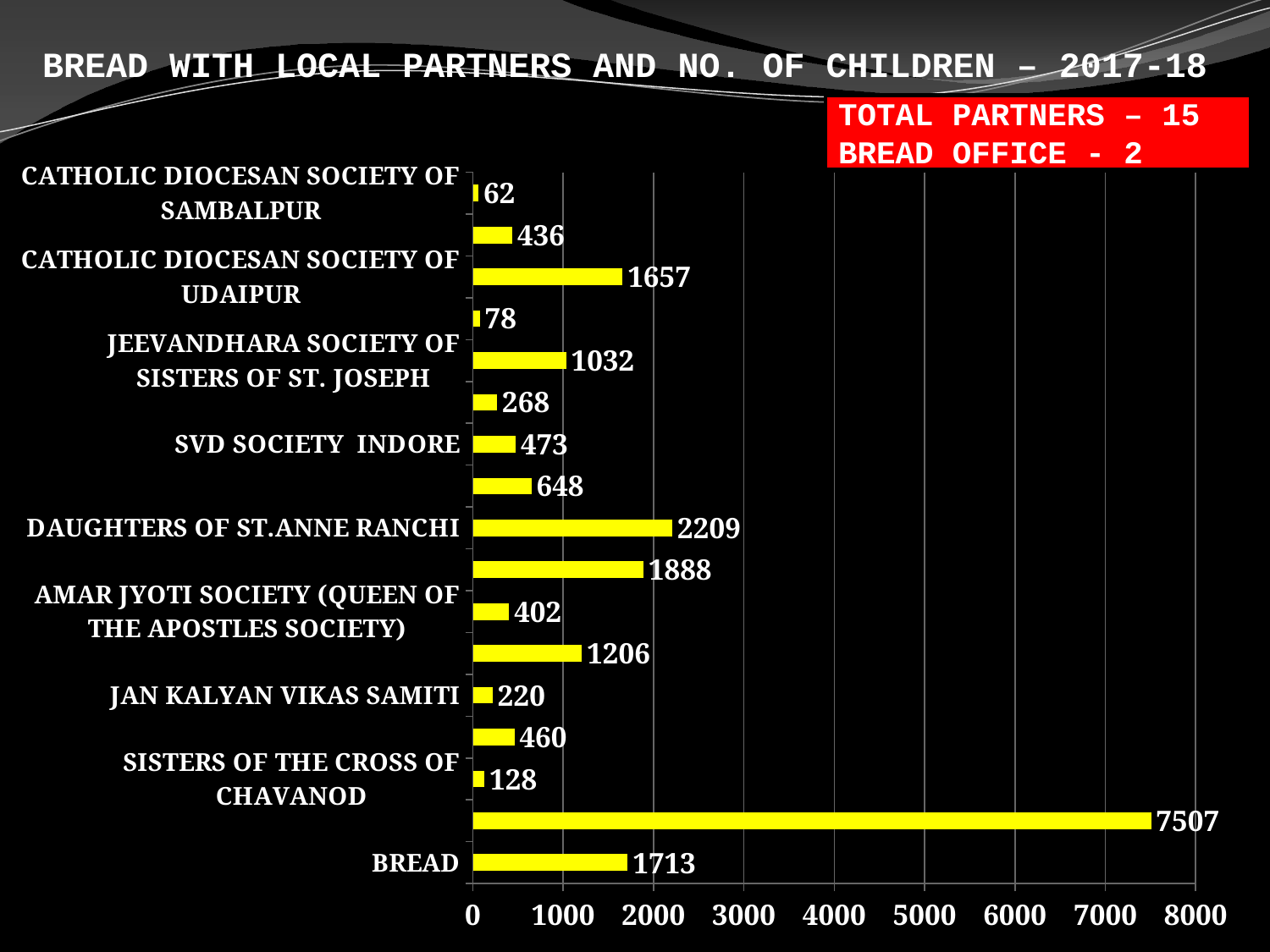
What is the largest value shown on the chart? 7507 What is the value for CATHOLIC DIOCESAN SOCIETY OF SAMBALPUR? 62 What is the value for BREAD? 1713 What type of chart is shown on the slide? bar chart Which labeled category has the lowest value on the chart? CATHOLIC DIOCESAN SOCIETY OF SAMBALPUR What is the value for DAUGHTERS OF ST.ANNE RANCHI? 2209 Which is larger, the value for DAUGHTERS OF ST.ANNE RANCHI or the value for JEEVANDHARA SOCIETY OF SISTERS OF ST. JOSEPH? DAUGHTERS OF ST.ANNE RANCHI What is the value for CATHOLIC DIOCESAN SOCIETY OF UDAIPUR? 1657 What is the difference between the values for BREAD and CATHOLIC DIOCESAN SOCIETY OF UDAIPUR? 56 What is the value for JAN KALYAN VIKAS SAMITI? 220 How many bars are plotted on the chart? 17 What is the title of the chart on the slide? BREAD WITH LOCAL PARTNERS AND NO. OF CHILDREN – 2017-18